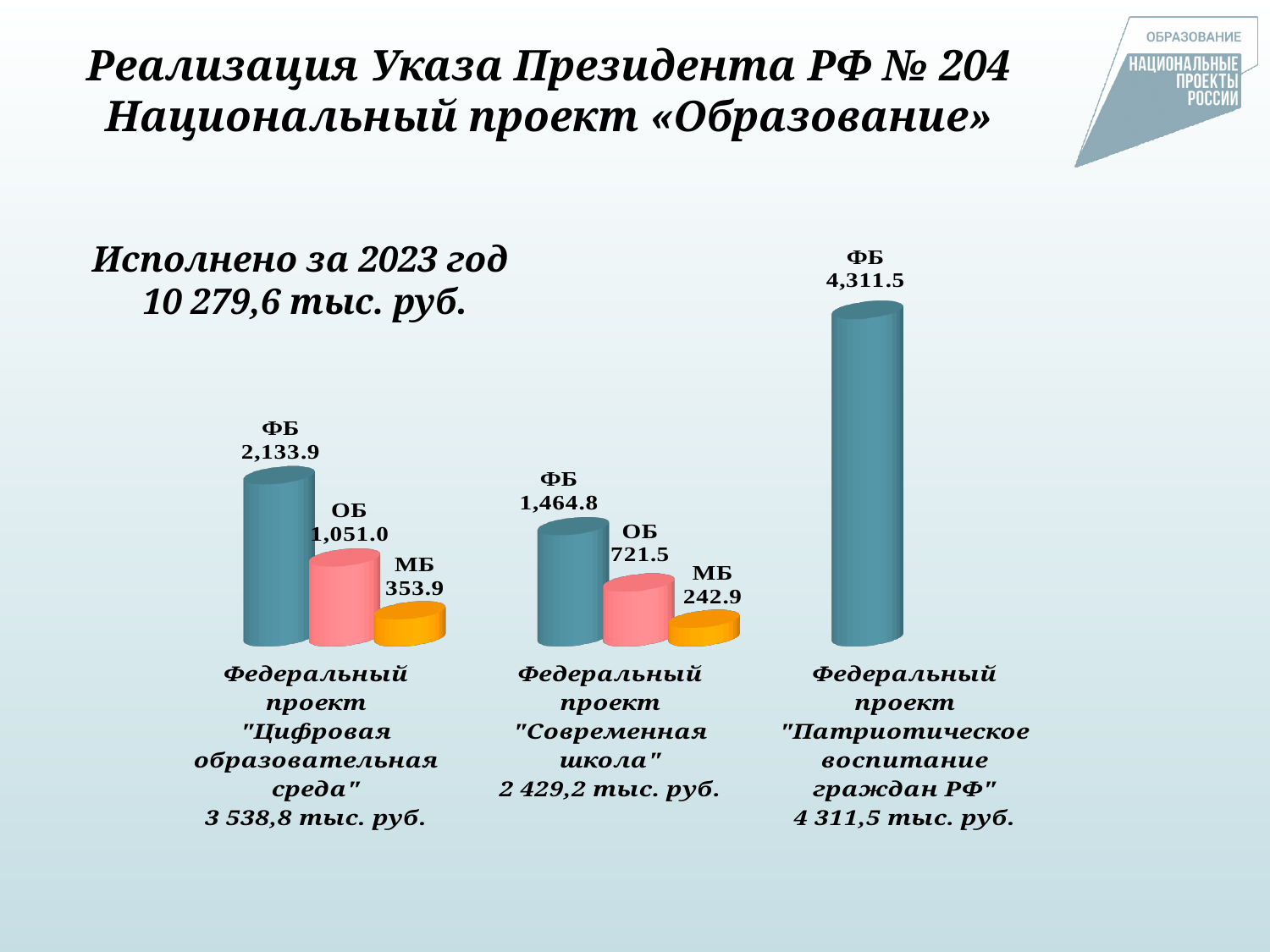
What is the ФБ value for the federal project "Патриотическое воспитание граждан РФ"? 4,311.5 What total amount executed for 2023 is stated on the slide? 10 279,6 тыс. руб. What is the difference between the ОБ values of "Цифровая образовательная среда" and "Современная школа"? 329.5 Which federal project has the lowest МБ value? Федеральный проект "Современная школа" What is the ФБ value for the federal project "Цифровая образовательная среда"? 2,133.9 Which is larger: the ФБ value for "Патриотическое воспитание граждан РФ" or the ФБ value for "Цифровая образовательная среда"? ФБ for "Патриотическое воспитание граждан РФ" Which federal project has the highest ФБ value? Федеральный проект "Патриотическое воспитание граждан РФ" How many federal projects (categories) are shown on the chart? 3 What is the МБ value for the federal project "Цифровая образовательная среда"? 353.9 What is the difference between the ФБ values of "Цифровая образовательная среда" and "Современная школа"? 669.1 What is the ОБ value for the federal project "Современная школа"? 721.5 What kind of chart is shown on the slide? Bar chart